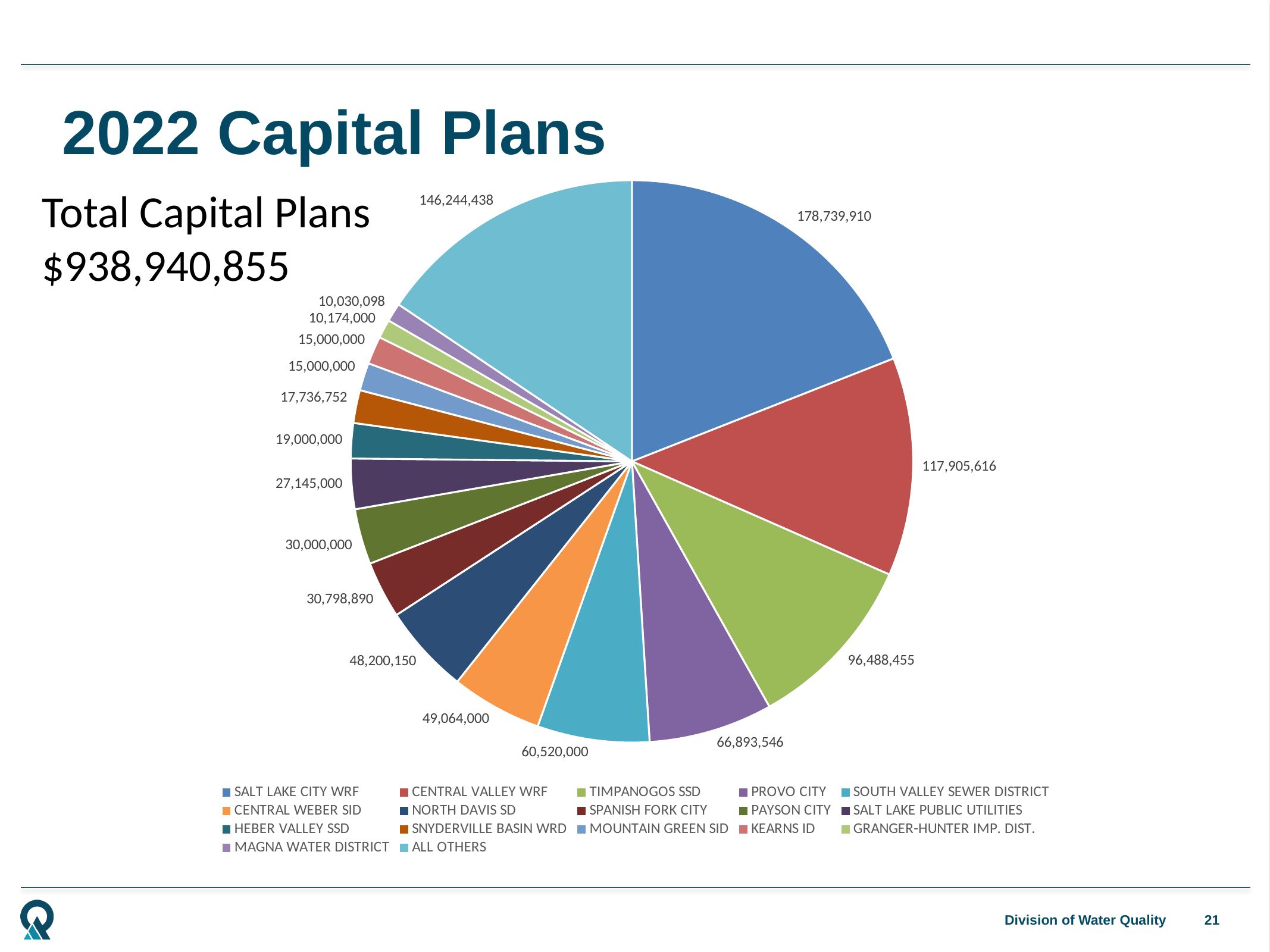
What is the difference between the values for SALT LAKE CITY WRF and CENTRAL VALLEY WRF? 60,834,294 How many slices does the pie chart have? 17 What is the value for CENTRAL VALLEY WRF? 117,905,616 What is the value for ALL OTHERS? 146,244,438 What type of chart is shown on the slide? Pie chart What is the value for SNYDERVILLE BASIN WRD? 17,736,752 Which category has the smallest slice of the pie? MAGNA WATER DISTRICT Which category has the largest slice of the pie? SALT LAKE CITY WRF What is the value for PROVO CITY? 66,893,546 Which is larger, the value for TIMPANOGOS SSD or the value for SOUTH VALLEY SEWER DISTRICT? TIMPANOGOS SSD What is the value for SALT LAKE CITY WRF? 178,739,910 What total capital plans amount is stated on the slide? $938,940,855